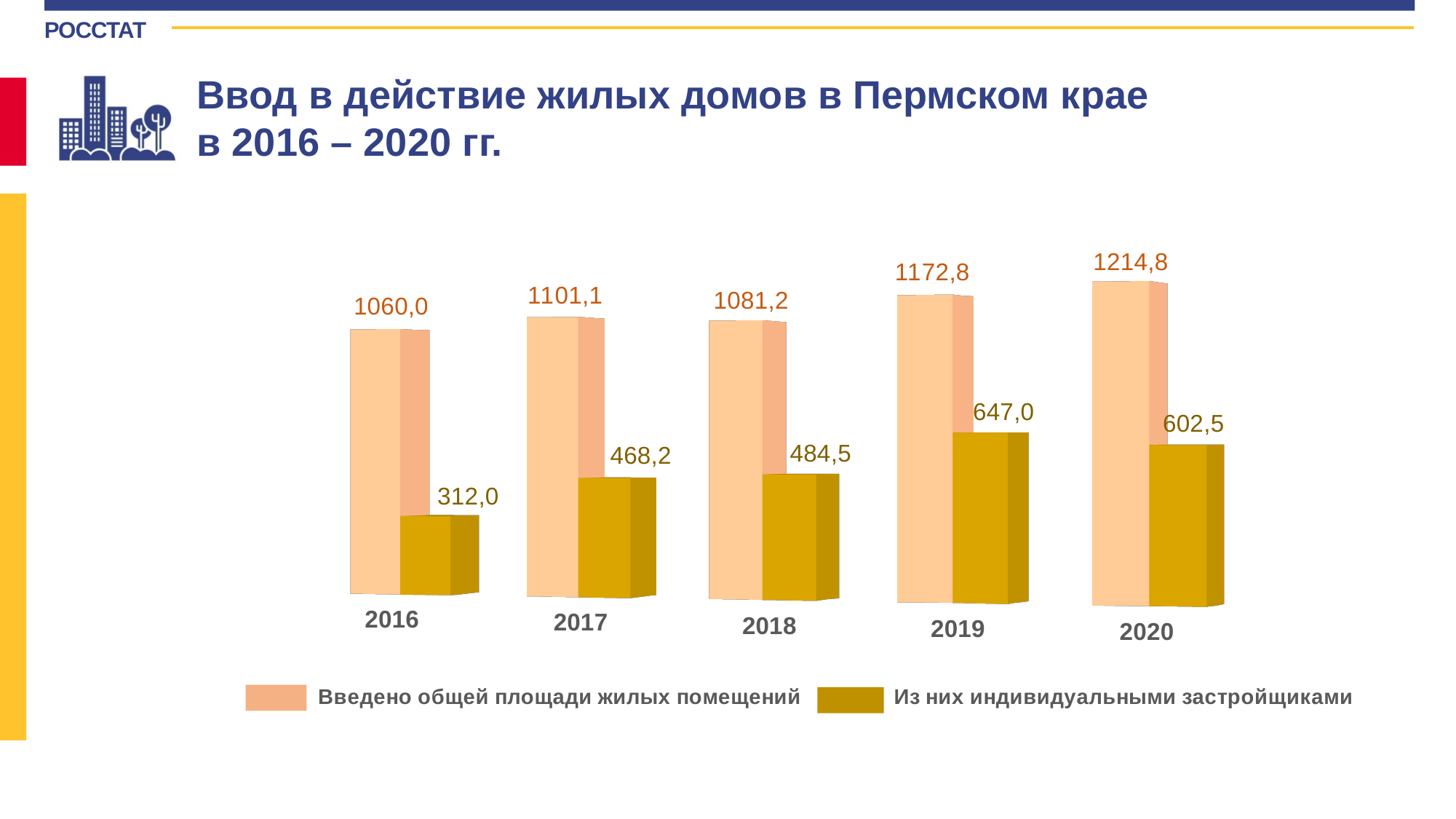
How many years are shown on the x axis? 5 What is the value of 'Введено общей площади жилых помещений' for 2016? 1060,0 What kind of chart is shown on the slide? Bar chart Which year has the highest value for 'Введено общей площади жилых помещений'? 2020 Does the value for 'Из них индивидуальными застройщиками' rise or fall from 2016 to 2019? Rise How many series does the legend list? 2 Which year has the lowest value for 'Из них индивидуальными застройщиками'? 2016 What is the difference between the 'Введено общей площади жилых помещений' values for 2020 and 2016? 154,8 What is the value of 'Введено общей площади жилых помещений' for 2020? 1214,8 Which is larger: 'Из них индивидуальными застройщиками' in 2019 or in 2020? 2019 What is the value of 'Из них индивидуальными застройщиками' for 2019? 647,0 What is the value of 'Из них индивидуальными застройщиками' for 2017? 468,2